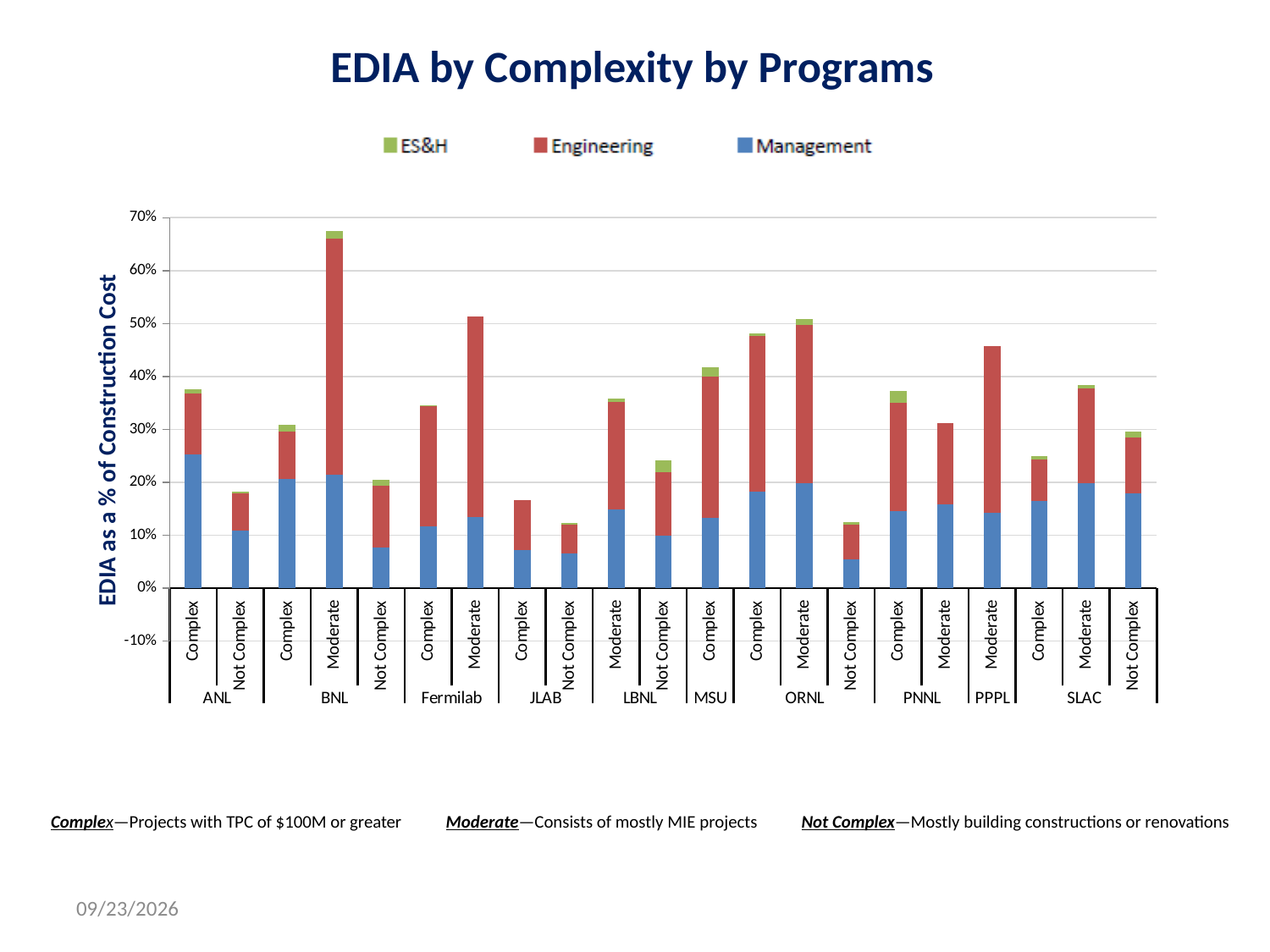
How many bars are plotted in the chart? 21 How many series does the legend list? 3 Is the total value for PPPL Moderate greater or less than 50%? less Is the total value for BNL Moderate greater or less than 60%? greater What is the y-axis label of the chart? EDIA as a % of Construction Cost Which has a larger total EDIA percentage, BNL Moderate or Fermilab Moderate? BNL Moderate Which bar has the highest total EDIA percentage? BNL Moderate What kind of chart is shown on the slide? Stacked bar chart Which has a larger total EDIA percentage, PPPL Moderate or PNNL Moderate? PPPL Moderate Which series are listed in the legend? ES&H, Engineering, Management How many programs (labs) are shown along the x axis? 10 Is the total value for JLAB Complex greater or less than 20%? less